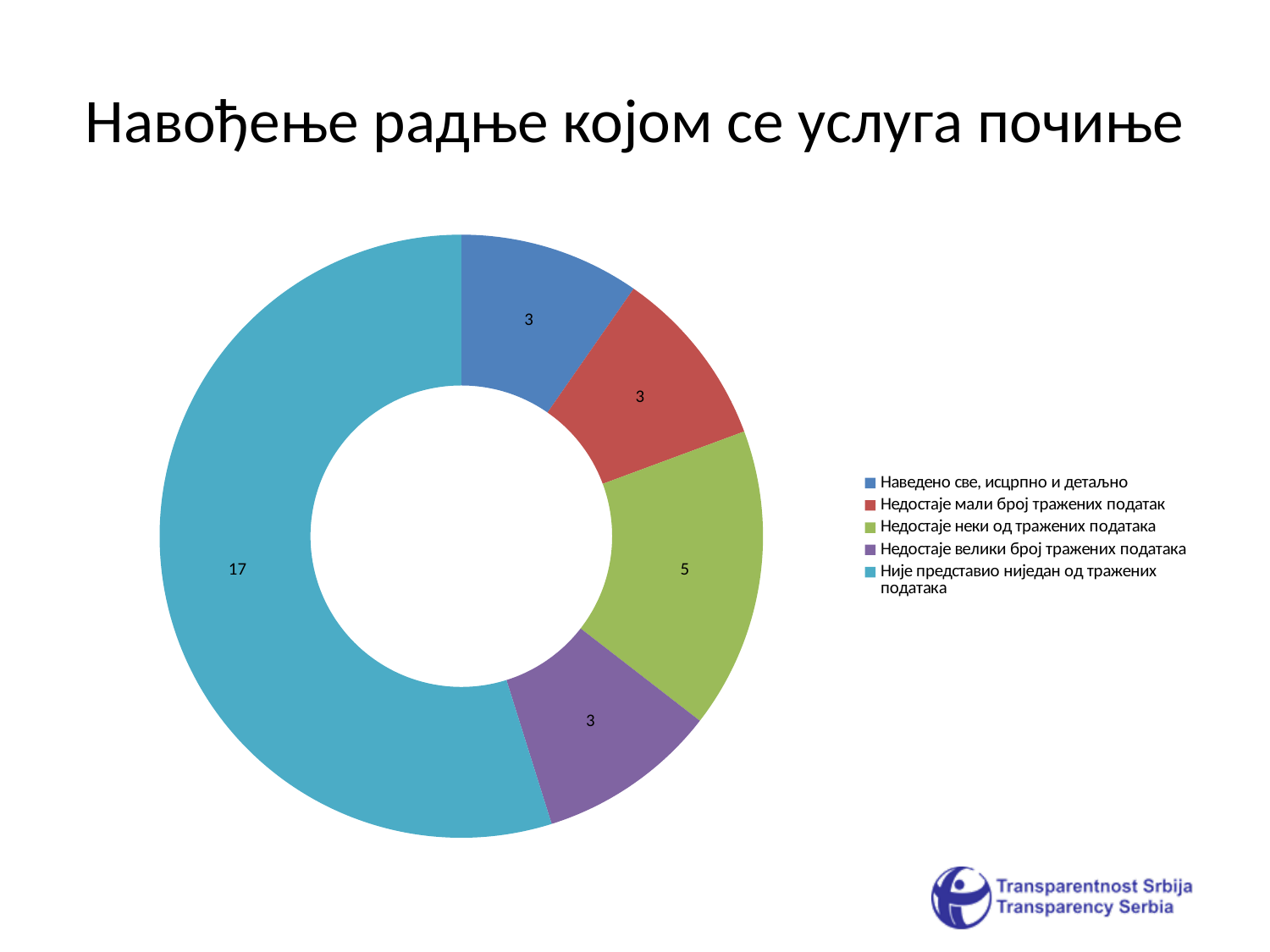
Which category has the highest value? Није представио ниједан од тражених података What is the title of the chart? Навођење радње којом се услуга почиње What is the value for "Наведено све, исцрпно и детаљно"? 3 What is the value for "Недостаје неки од тражених података"? 5 What colour is the slice for "Недостаје мали број тражених податак"? Red What is the value for "Није представио ниједан од тражених података"? 17 Which is larger: the value for "Недостаје неки од тражених података" or the value for "Недостаје мали број тражених податак"? Недостаје неки од тражених података What is the total of all values shown in the chart? 31 What kind of chart is shown on the slide? Doughnut chart What is the difference between the value for "Није представио ниједан од тражених података" and the value for "Недостаје неки од тражених података"? 12 What is the value for "Недостаје велики број тражених података"? 3 How many categories does the chart show? 5